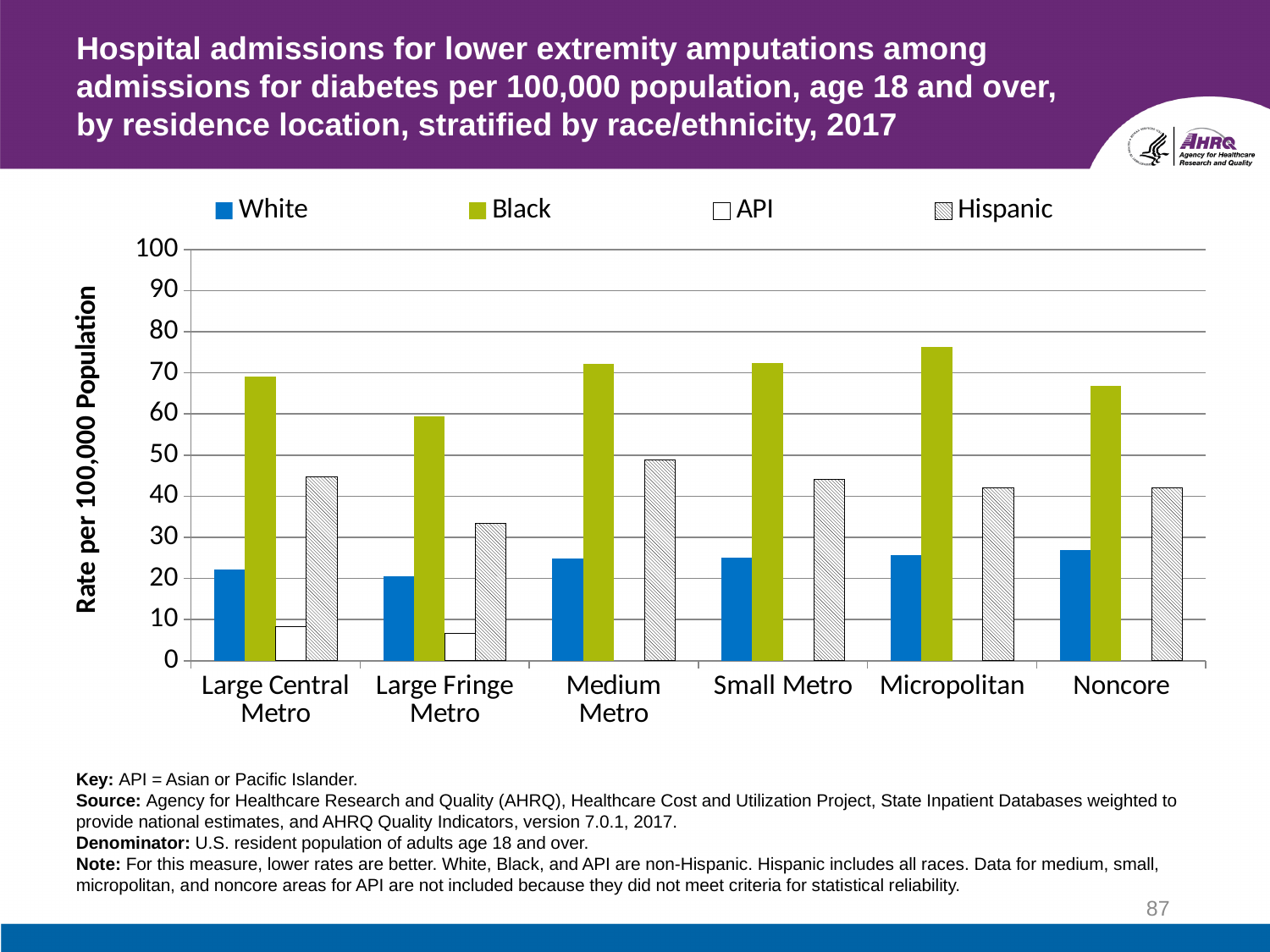
What kind of chart is shown on the slide? bar chart How many residence location categories are shown on the x axis? 6 In Large Central Metro, which is larger, the rate for Black or the rate for Hispanic? Black Is the value for API in Large Central Metro greater or less than 10? less Which residence location has the highest rate for Black? Micropolitan How many series does the legend list? 4 What is the title of the y axis? Rate per 100,000 Population Is the value for Black in Large Central Metro greater or less than 60? greater Is the value for Hispanic in Large Fringe Metro greater or less than 40? less Which residence location has the lowest rate for Black? Large Fringe Metro Which residence location has the lowest rate for Hispanic? Large Fringe Metro